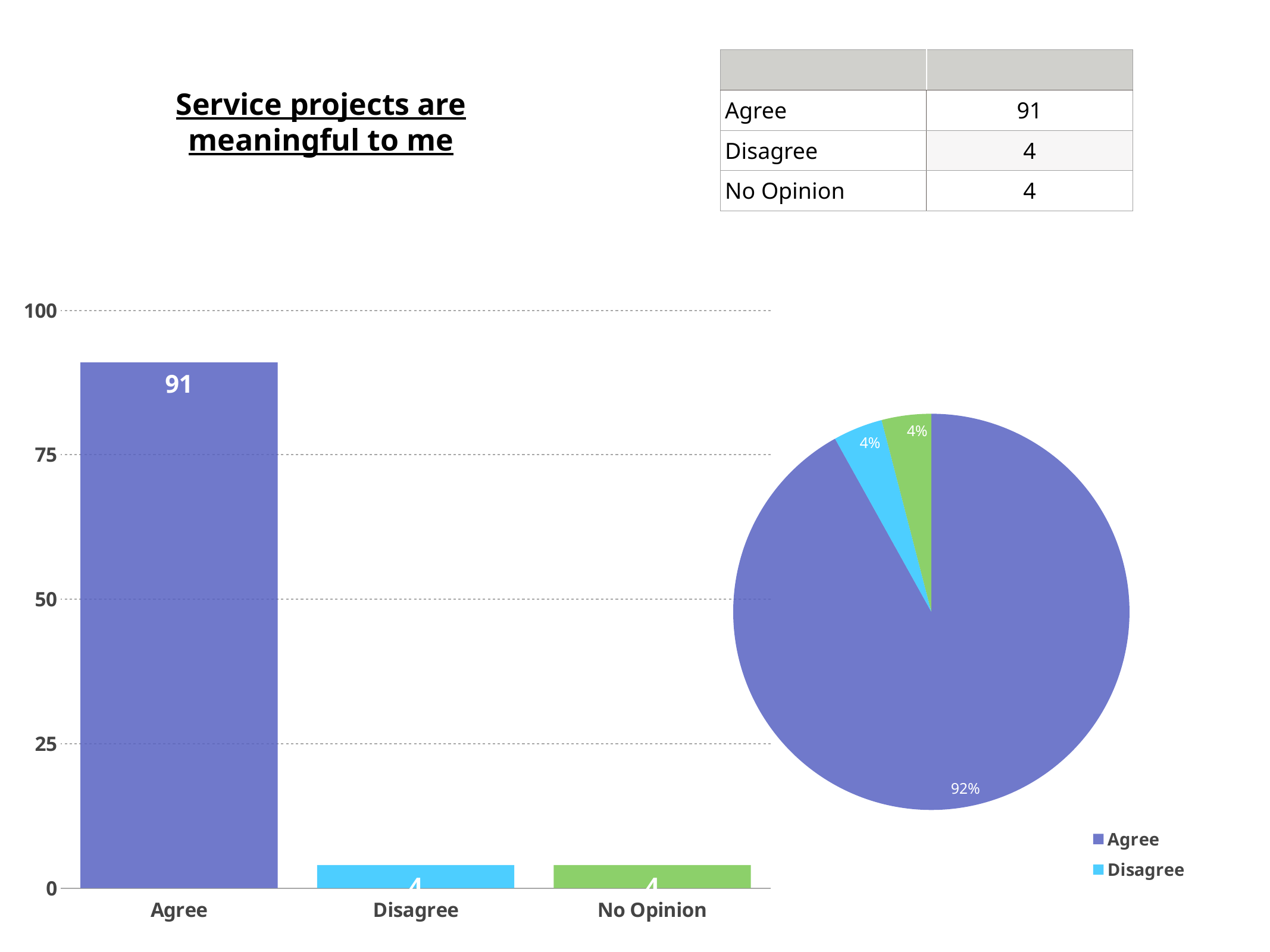
In the bar chart on the left, what is the value for No Opinion? 4 In the bar chart on the left, what is the difference between the values for Agree and Disagree? 87 In the bar chart on the left, what is the value for Agree? 91 How many categories are shown in the bar chart on the left? 3 In the pie chart on the right, what share does the Disagree slice have? 4% What kind of chart is on the left of the slide? bar chart In the pie chart on the right, what share does the Agree slice have? 92% In the bar chart on the left, which category has the highest value? Agree In the bar chart on the left, is the value for Agree greater or less than 75? greater What kind of chart is on the right of the slide? pie chart In the bar chart on the left, which is larger, the value for Agree or the value for No Opinion? Agree In the bar chart on the left, what is the value for Disagree? 4